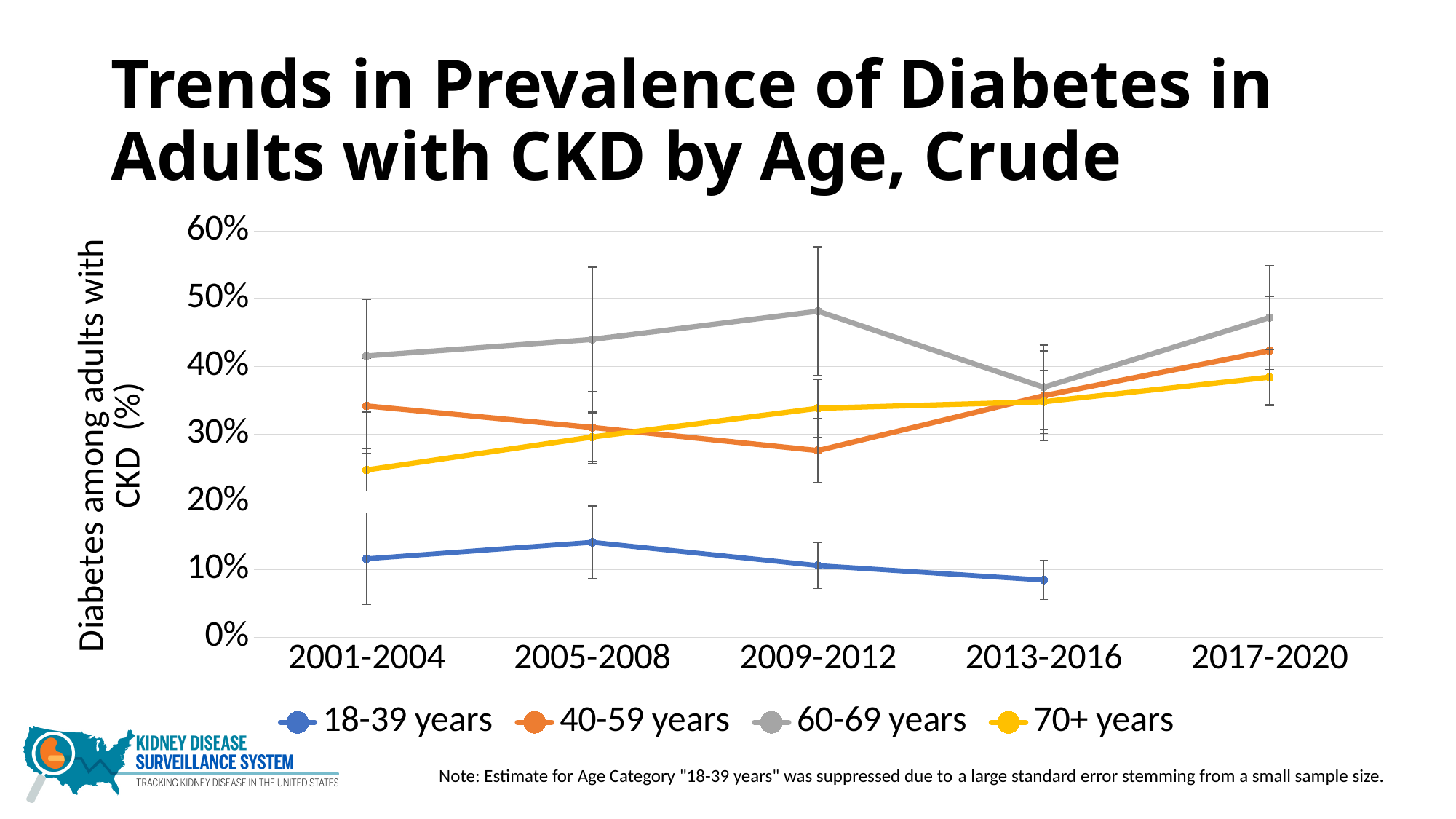
Is the value for 18-39 years in 2005-2008 greater or less than 20%? less What kind of chart is shown on the slide? Line chart Which age group has the lowest diabetes prevalence in 2001-2004? 18-39 years Is the value for 60-69 years in 2009-2012 greater or less than 40%? greater Which age group has no data point plotted for 2017-2020? 18-39 years How many series does the legend list? 4 Is the value for 70+ years in 2001-2004 greater or less than 30%? less Does the value for 70+ years rise or fall from 2001-2004 to 2017-2020? rise Which age group has the highest diabetes prevalence in 2009-2012? 60-69 years How many time periods are shown on the x axis? 5 In 2009-2012, which is larger: the value for 40-59 years or for 70+ years? 70+ years